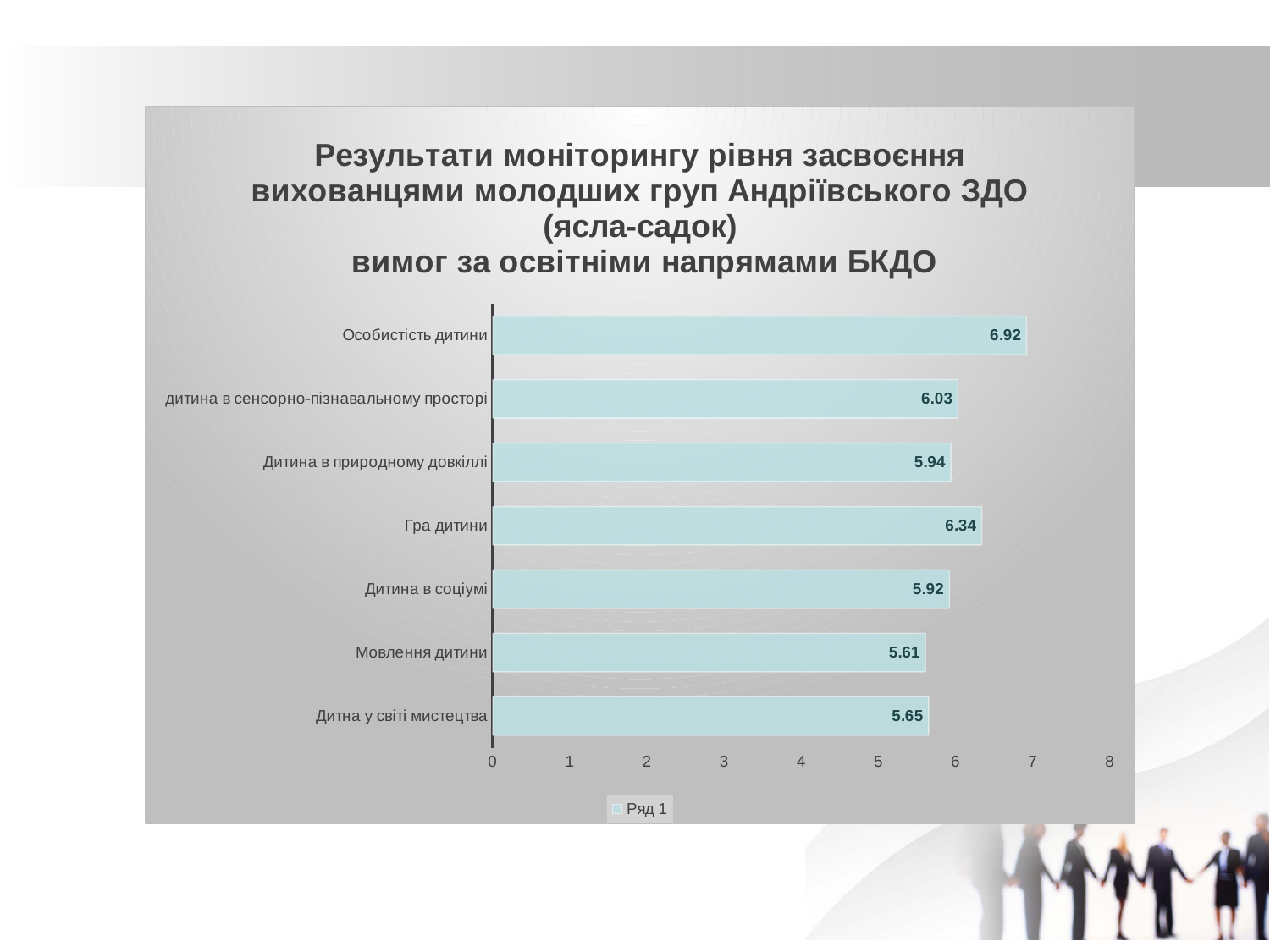
Which is larger, the value for Гра дитини or the value for Дитина в соціумі? Гра дитини What is the value for Мовлення дитини? 5.61 How many categories are shown in the chart? 7 Is the value for Дитна у світі мистецтва greater or less than 6? less What kind of chart is shown on the slide? bar chart What is the value for Гра дитини? 6.34 How many series does the legend list? 1 What is the value for Особистість дитини? 6.92 What is the difference between the values for Особистість дитини and Мовлення дитини? 1.31 Which category has the lowest value? Мовлення дитини What is the value for Дитина в природному довкіллі? 5.94 Which category has the highest value? Особистість дитини